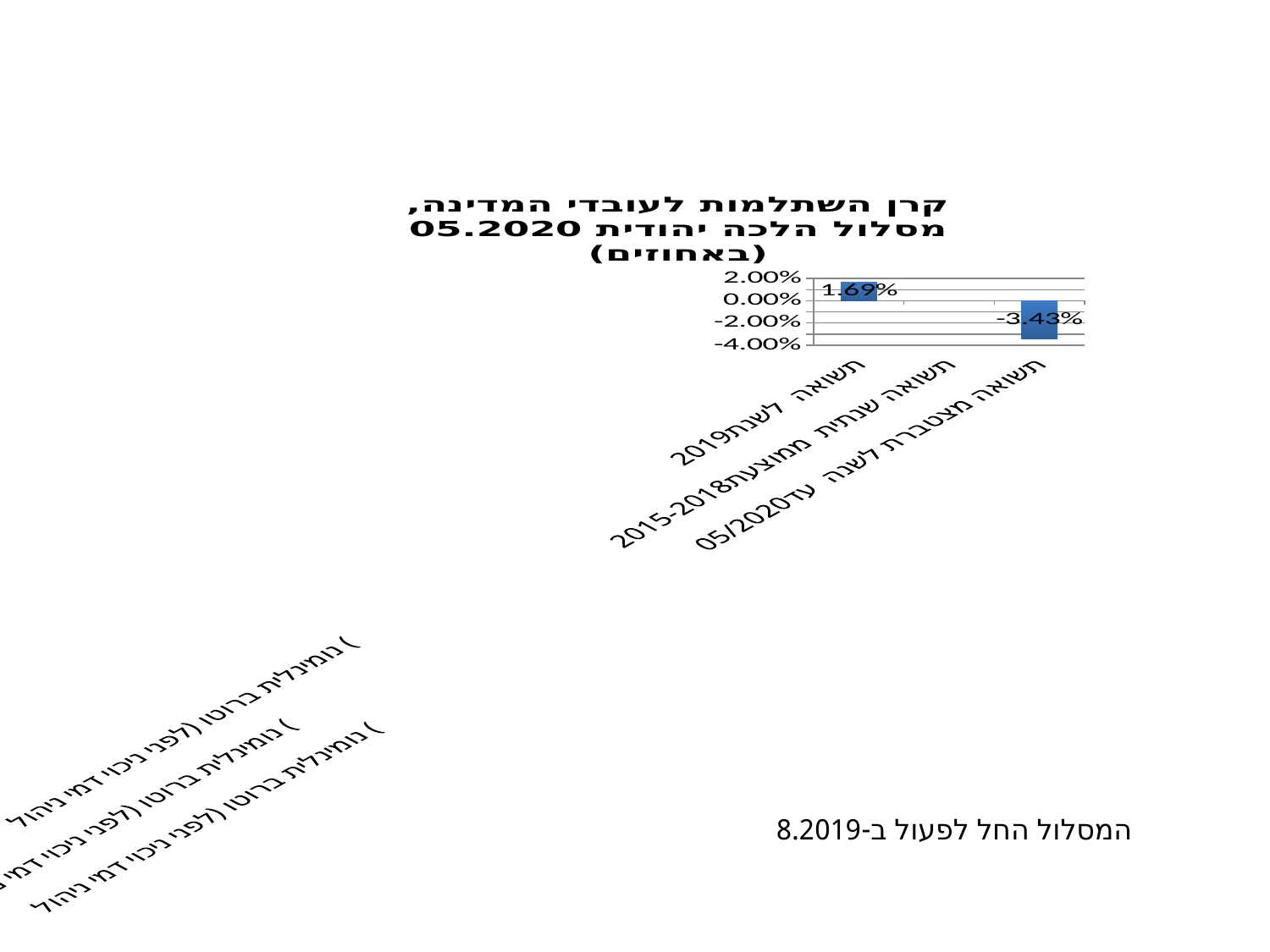
How many categories are shown on the x axis of the chart? 3 Is the value for 'תשואה מצטברת לשנה עד 05/2020' greater or less than -2.00%? less Which is larger: the value for 'תשואה לשנת 2019' or the value for 'תשואה מצטברת לשנה עד 05/2020'? תשואה לשנת 2019 What is the value for 'תשואה מצטברת לשנה עד 05/2020'? -3.43% Is the value for 'תשואה לשנת 2019' greater or less than 0.00%? greater What is the lowest value shown on the y axis of the chart? -4.00% What is the difference between the value for 'תשואה לשנת 2019' and the value for 'תשואה מצטברת לשנה עד 05/2020'? 5.12% Which category has the lowest value? תשואה מצטברת לשנה עד 05/2020 Which category has the highest value? תשואה לשנת 2019 What is the title of the chart? קרן השתלמות לעובדי המדינה, מסלול הלכה יהודית 05.2020 (באחוזים) What is the value for 'תשואה לשנת 2019'? 1.69% What kind of chart is shown on the slide? bar chart